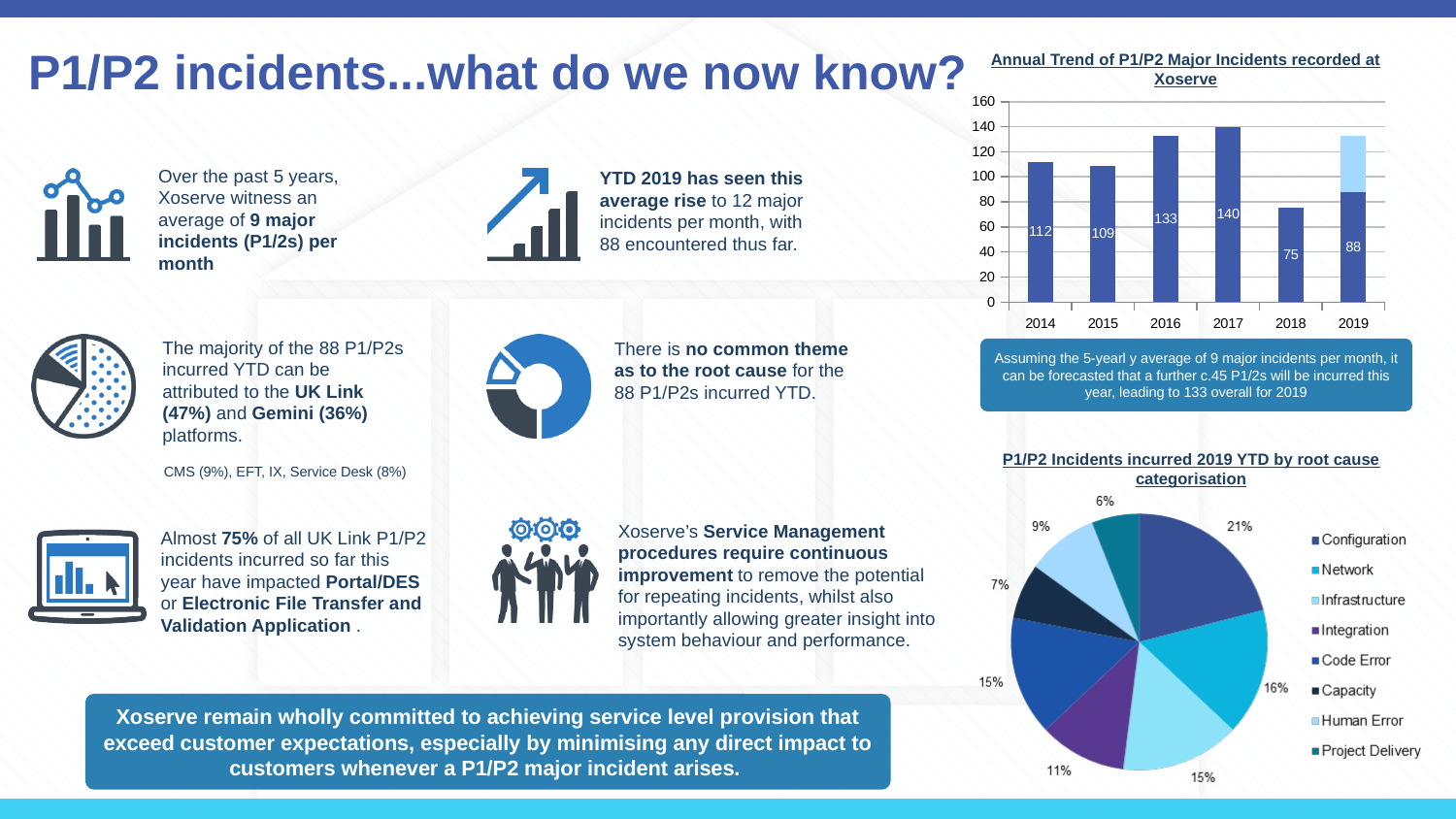
In the 'Annual Trend of P1/P2 Major Incidents recorded at Xoserve' chart, do the values rise or fall from 2017 to 2018? Fall In the 'Annual Trend of P1/P2 Major Incidents recorded at Xoserve' chart, what is the difference between the 2017 and 2018 values? 65 In the 'Annual Trend of P1/P2 Major Incidents recorded at Xoserve' chart, which year has the highest number of incidents? 2017 In the 'P1/P2 Incidents incurred 2019 YTD by root cause categorisation' pie chart, which root cause has the largest share? Configuration What kind of chart is the 'Annual Trend of P1/P2 Major Incidents recorded at Xoserve' chart? Bar chart In the 'Annual Trend of P1/P2 Major Incidents recorded at Xoserve' chart, what is the value for 2017? 140 In the 'Annual Trend of P1/P2 Major Incidents recorded at Xoserve' chart, which year has the lowest number of incidents? 2018 In the 'P1/P2 Incidents incurred 2019 YTD by root cause categorisation' pie chart, what share is shown for Configuration? 21% How many categories does the legend of the 'P1/P2 Incidents incurred 2019 YTD by root cause categorisation' pie chart list? 8 In the 'Annual Trend of P1/P2 Major Incidents recorded at Xoserve' chart, how many years are shown on the x axis? 6 In the 'Annual Trend of P1/P2 Major Incidents recorded at Xoserve' chart, what is the value for 2014? 112 In the 'Annual Trend of P1/P2 Major Incidents recorded at Xoserve' chart, which year has the larger value, 2014 or 2015? 2014